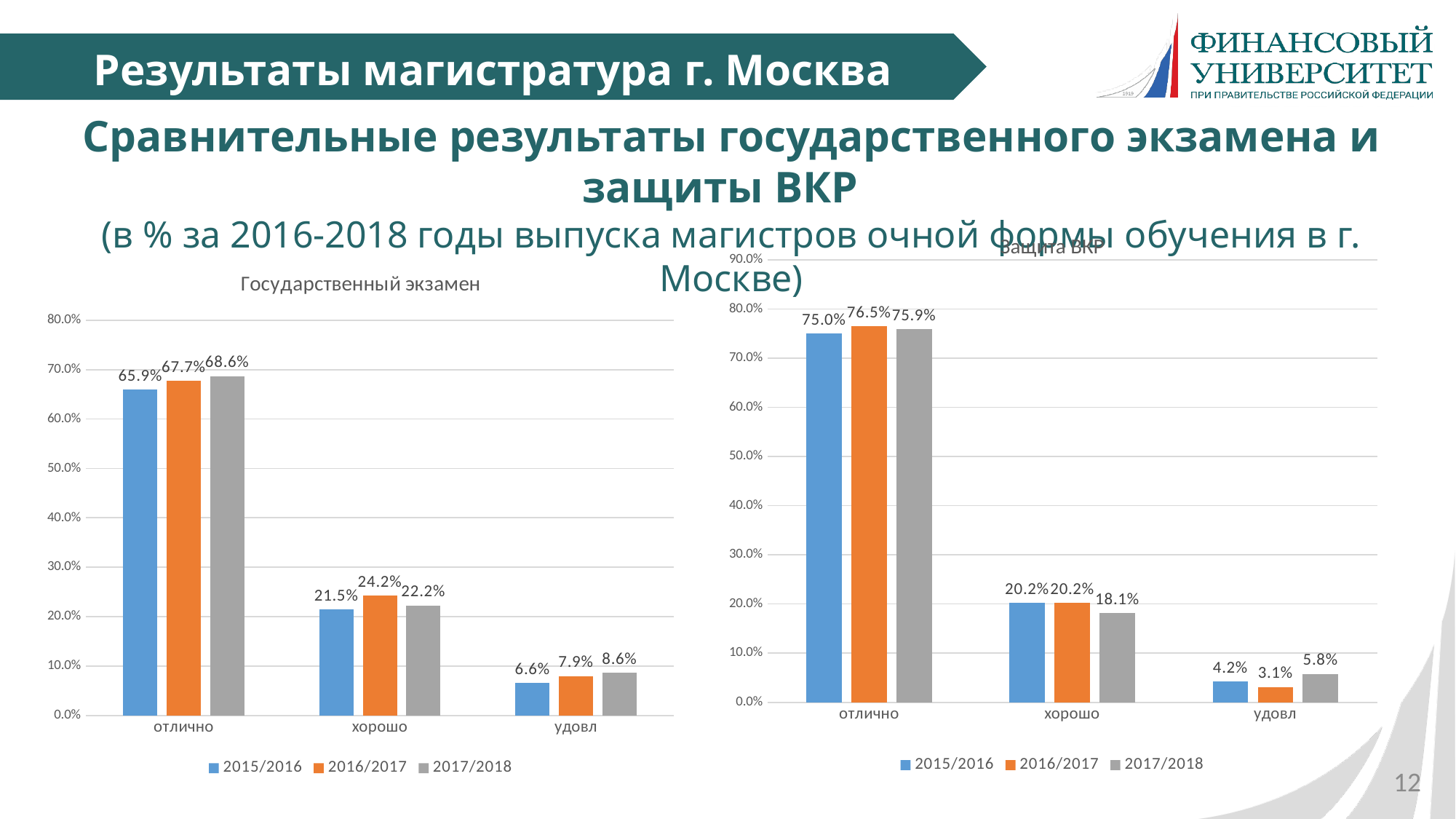
In the 'Защита ВКР' chart, what is the value for 'удовл' in 2016/2017? 3.1% In the 'Государственный экзамен' chart, which category has the lowest value for 2015/2016? удовл In the 'Государственный экзамен' chart, do the values for 'удовл' rise or fall from 2015/2016 to 2017/2018? rise In the 'Государственный экзамен' chart, which is larger for 'удовл': 2015/2016 or 2017/2018? 2017/2018 In the 'Государственный экзамен' chart, what is the value for 'отлично' in 2017/2018? 68.6% What kind of chart is the 'Государственный экзамен' chart? bar chart In the 'Защита ВКР' chart, what is the difference between the 2016/2017 and 2017/2018 values for 'хорошо'? 2.1% In the 'Защита ВКР' chart, which year has the highest value for 'удовл'? 2017/2018 In the 'Государственный экзамен' chart, what is the value for 'хорошо' in 2016/2017? 24.2% In the 'Государственный экзамен' chart, what is the difference between the 2017/2018 and 2015/2016 values for 'отлично'? 2.7% In the 'Защита ВКР' chart, what is the value for 'отлично' in 2015/2016? 75.0% How many series does the legend of the 'Защита ВКР' chart list? 3